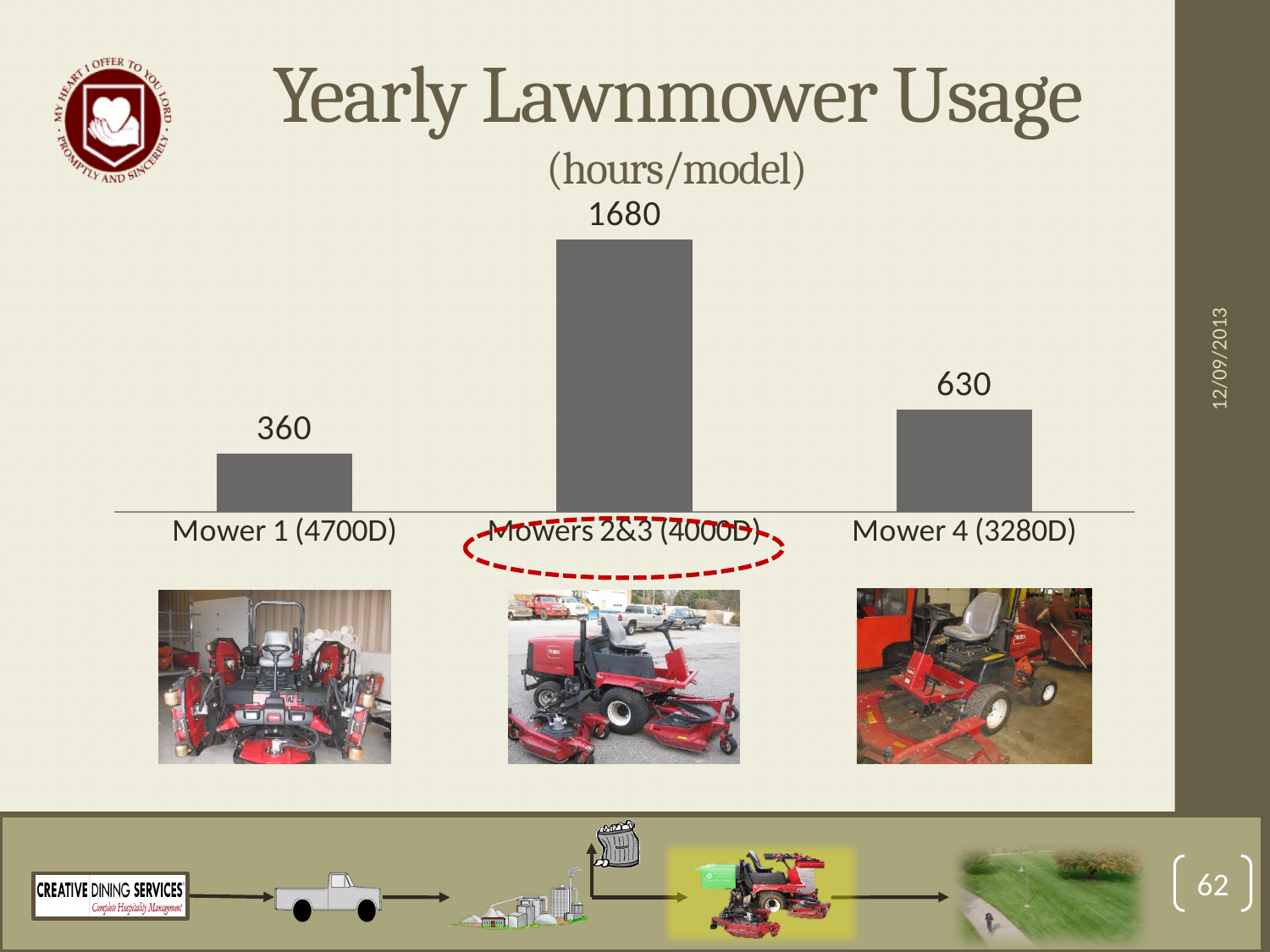
Which category has the lowest yearly usage? Mower 1 (4700D) What is the yearly usage value for Mower 1 (4700D)? 360 What is the yearly usage value for Mowers 2&3 (4000D)? 1680 What unit is given in the chart's subtitle? hours/model Which has a larger usage value, Mower 1 (4700D) or Mower 4 (3280D)? Mower 4 (3280D) What is the yearly usage value for Mower 4 (3280D)? 630 How many categories are shown in the chart? 3 What is the total usage across all three categories in the chart? 2670 What kind of chart is shown on the slide? Bar chart Which category has the highest yearly usage? Mowers 2&3 (4000D) What is the difference in usage between Mowers 2&3 (4000D) and Mower 4 (3280D)? 1050 What is the difference in usage between Mower 4 (3280D) and Mower 1 (4700D)? 270